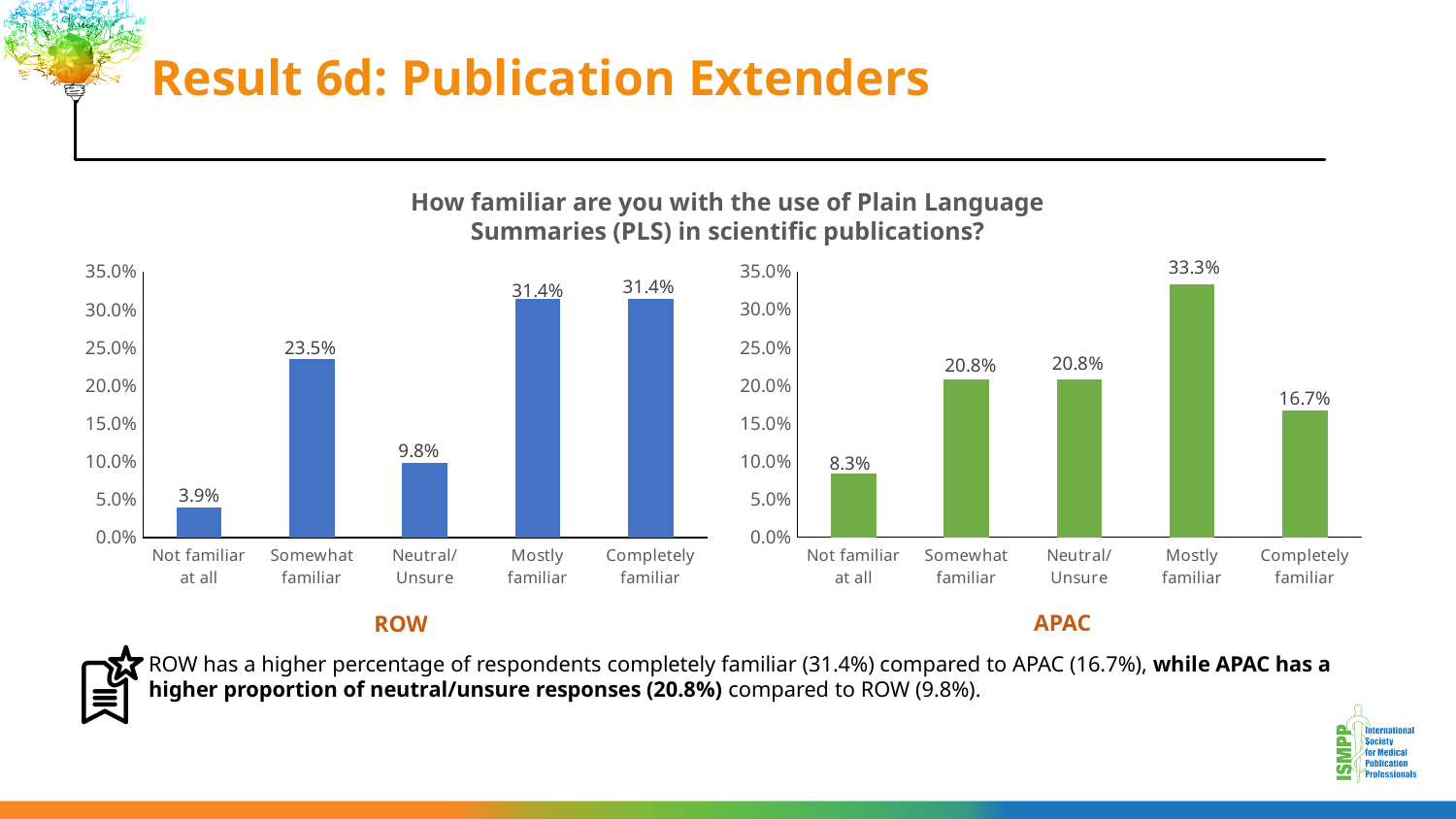
In the APAC chart, what is the value for 'Mostly familiar'? 33.3% In the APAC chart, which category has the highest value? Mostly familiar In the ROW chart, what is the value for 'Somewhat familiar'? 23.5% How many categories are shown in the ROW chart? 5 In the APAC chart, which category has the lowest value? Not familiar at all What type of chart is the APAC chart? Bar chart In the APAC chart, what is the difference between 'Mostly familiar' and 'Completely familiar'? 16.6% In the ROW chart, which category has the lowest value? Not familiar at all In the ROW chart, what is the value for 'Not familiar at all'? 3.9% Which is larger: 'Completely familiar' in the ROW chart or 'Completely familiar' in the APAC chart? ROW In the APAC chart, is the value for 'Not familiar at all' greater or less than 10.0%? less In the ROW chart, what is the difference between 'Mostly familiar' and 'Neutral/Unsure'? 21.6%